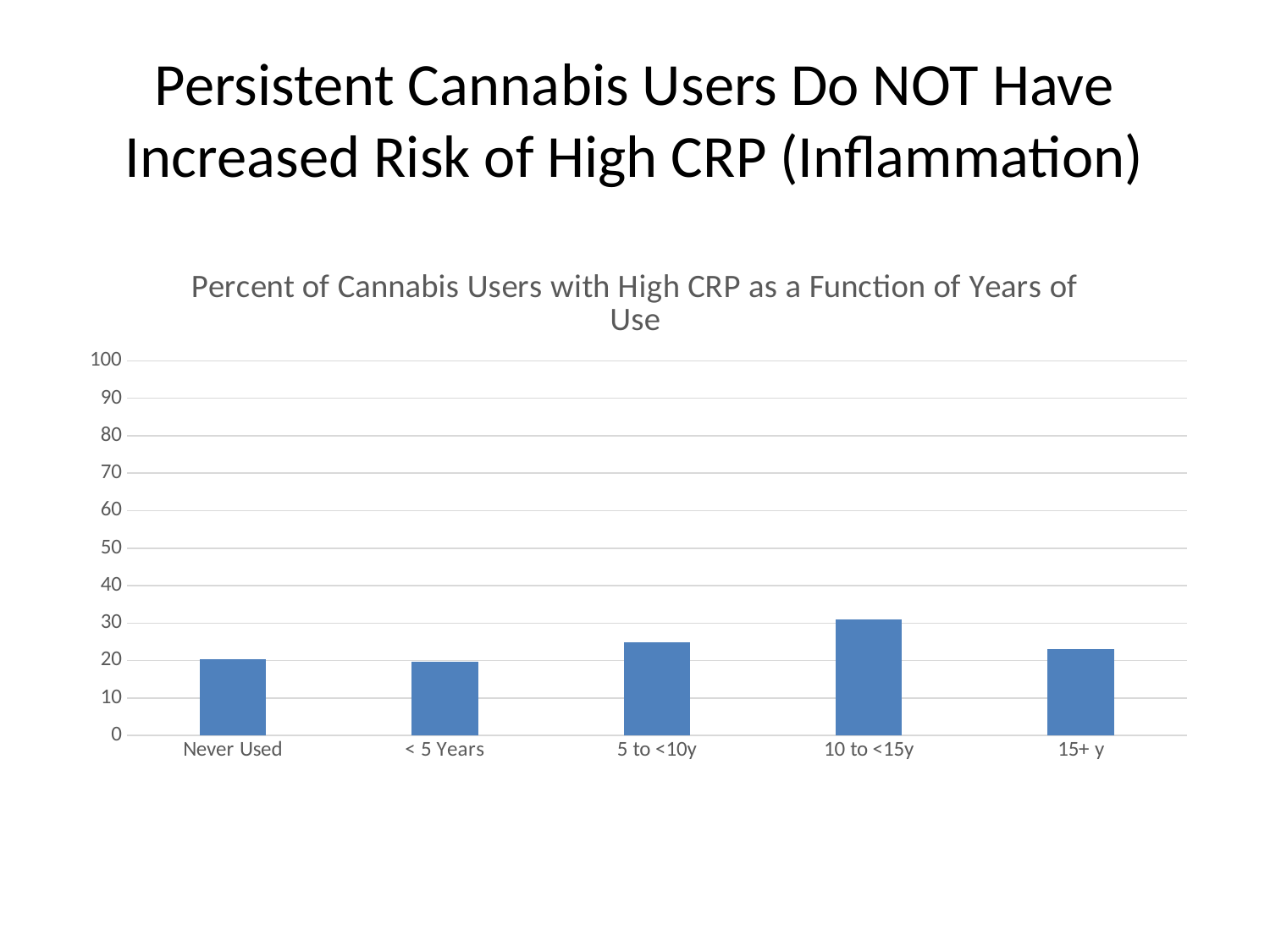
What is the title of the chart? Percent of Cannabis Users with High CRP as a Function of Years of Use What kind of chart is shown on the slide? bar chart Is the value for 15+ y greater or less than 30? less Which is larger, the value for 10 to <15y or the value for 15+ y? 10 to <15y Is the value for < 5 Years greater or less than 10? greater Does the value rise or fall from 10 to <15y to 15+ y? fall Is the value for 5 to <10y greater or less than 20? greater How many categories are shown on the x axis of the chart? 5 Which is larger, the value for 5 to <10y or the value for Never Used? 5 to <10y Which category has the highest percent of users with high CRP? 10 to <15y